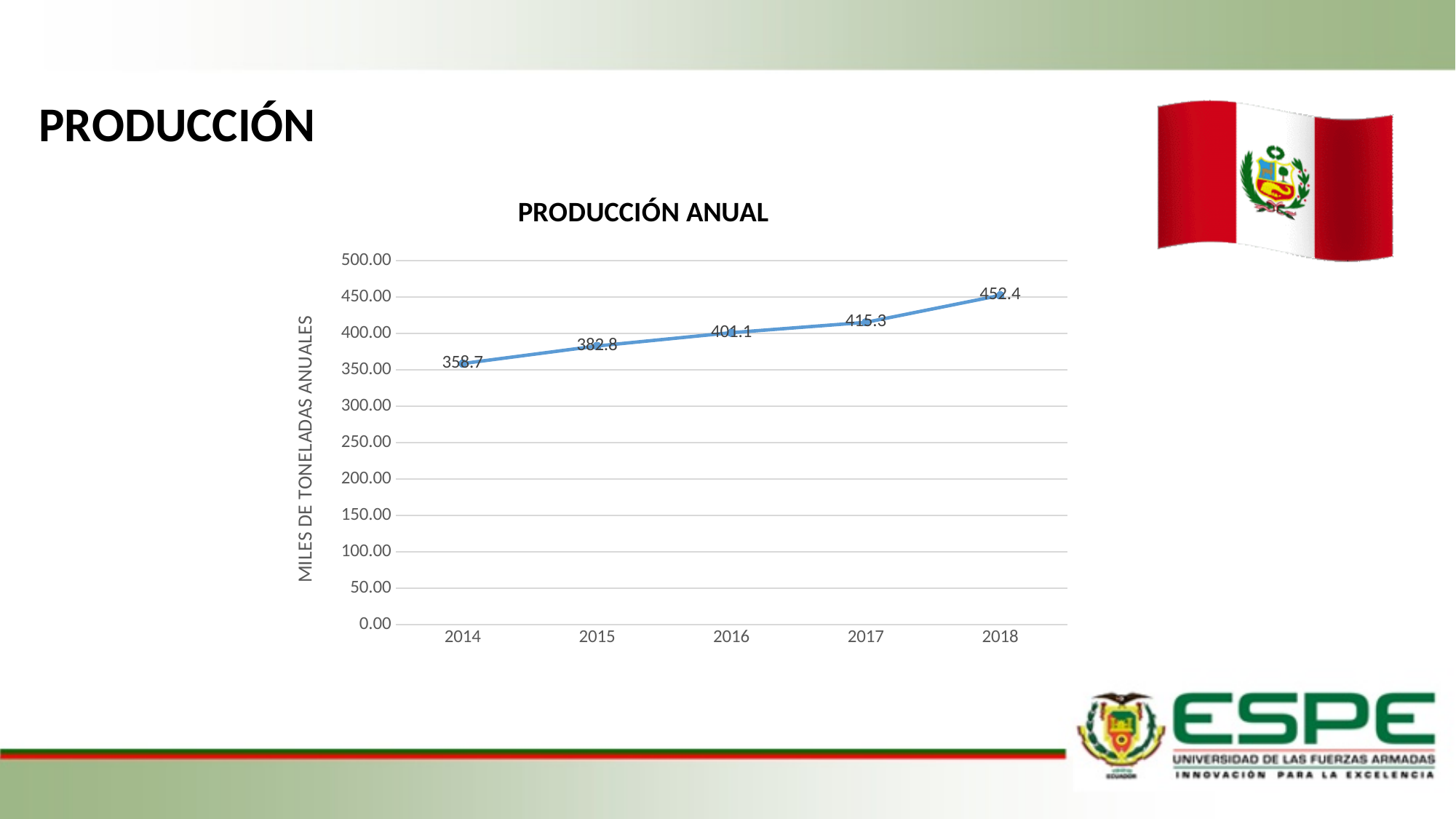
Do the values in the PRODUCCIÓN ANUAL chart rise or fall from 2014 to 2018? rise What is the value for 2016 in the PRODUCCIÓN ANUAL chart? 401.1 Which is larger in the PRODUCCIÓN ANUAL chart, the value for 2015 or the value for 2017? 2017 How many years are plotted in the PRODUCCIÓN ANUAL chart? 5 What is the value for 2018 in the PRODUCCIÓN ANUAL chart? 452.4 What is the difference between the 2017 and 2016 values in the PRODUCCIÓN ANUAL chart? 14.2 What is the difference between the 2018 and 2014 values in the PRODUCCIÓN ANUAL chart? 93.7 What is the value for 2014 in the PRODUCCIÓN ANUAL chart? 358.7 Which year has the lowest value in the PRODUCCIÓN ANUAL chart? 2014 Which year has the highest value in the PRODUCCIÓN ANUAL chart? 2018 Is the value for 2015 in the PRODUCCIÓN ANUAL chart greater or less than 400.00? less What kind of chart is the PRODUCCIÓN ANUAL chart? line chart